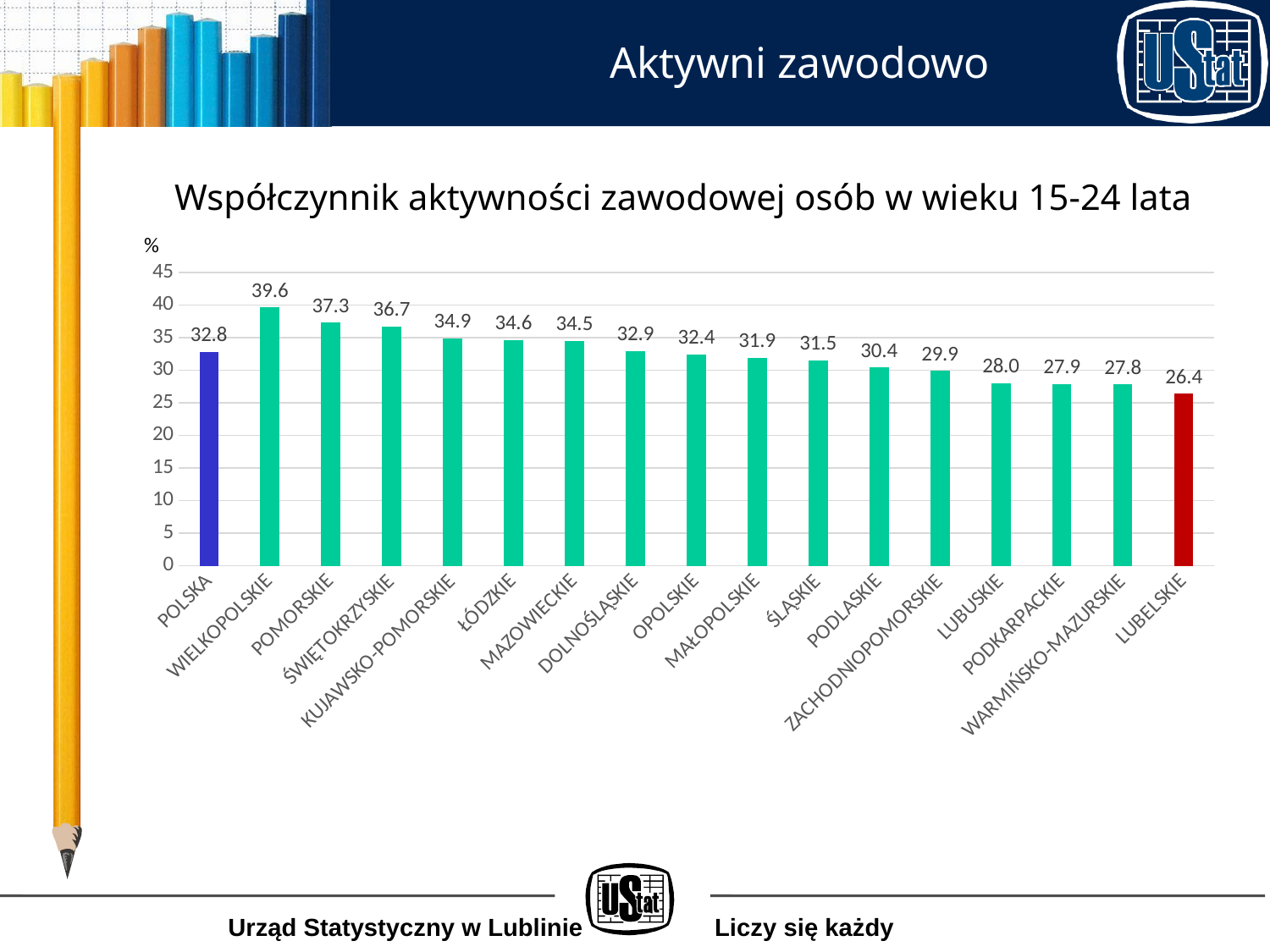
How many categories are shown on the x axis? 17 Which category has the highest value? WIELKOPOLSKIE What is the value for LUBELSKIE? 26.4 What is the difference between the values for WIELKOPOLSKIE and LUBELSKIE? 13.2 Which category has the lowest value? LUBELSKIE What is the title of the chart? Współczynnik aktywności zawodowej osób w wieku 15-24 lata Which is larger, the value for POMORSKIE or the value for ŁÓDZKIE? POMORSKIE What is the value for ZACHODNIOPOMORSKIE? 29.9 What is the value for POLSKA? 32.8 What is the value for WIELKOPOLSKIE? 39.6 What is the difference between the values for POLSKA and LUBELSKIE? 6.4 What kind of chart is shown on the slide? bar chart